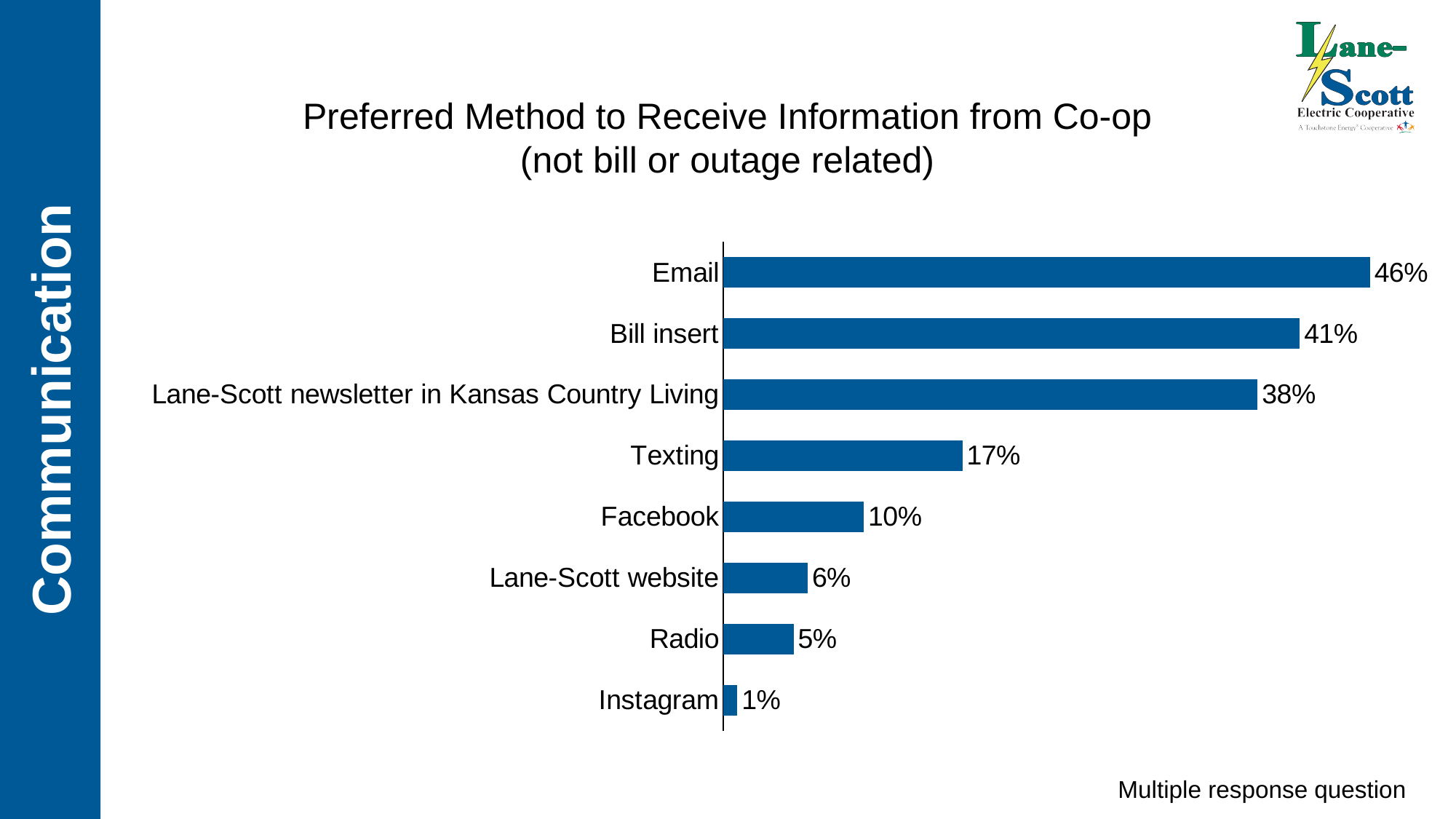
What kind of chart is shown on the slide? Bar chart What is the title of the chart? Preferred Method to Receive Information from Co-op (not bill or outage related) Which preferred method has the highest percentage? Email Which has a higher percentage, Bill insert or Facebook? Bill insert What is the difference in percentage points between Texting and Facebook? 7 Which preferred method has the lowest percentage? Instagram What percentage is shown for the Lane-Scott newsletter in Kansas Country Living? 38% Which has a higher percentage, Lane-Scott website or Radio? Lane-Scott website What is the value shown for Texting? 17% What is the difference in percentage points between Email and Bill insert? 5 How many preferred methods are shown in the chart? 8 What percentage of respondents prefer Email as the method to receive information from the co-op? 46%